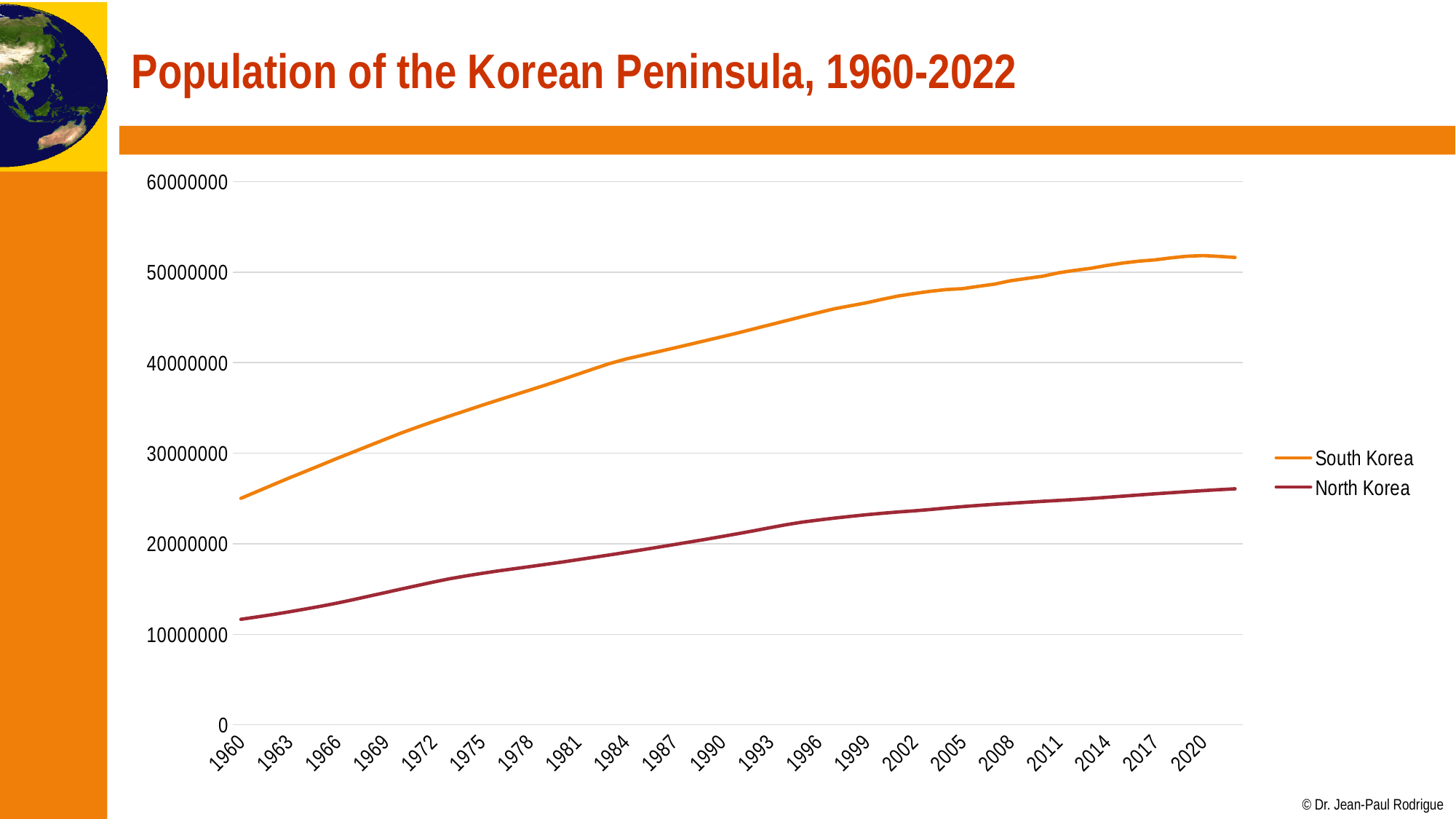
What is the title of the slide's chart? Population of the Korean Peninsula, 1960-2022 Is the value for North Korea in 1960 greater or less than 10000000? greater Is the value for North Korea in 2020 greater or less than 30000000? less What are the two series named in the legend? South Korea and North Korea What kind of chart is shown on the slide? line chart Is the value for South Korea in 1990 greater or less than 40000000? greater Does the North Korea line rise or fall from 1960 to 2020? rise Which series has the higher value in 2020, South Korea or North Korea? South Korea How many series does the legend list? 2 Does the South Korea line rise or fall from 1960 to 2020? rise